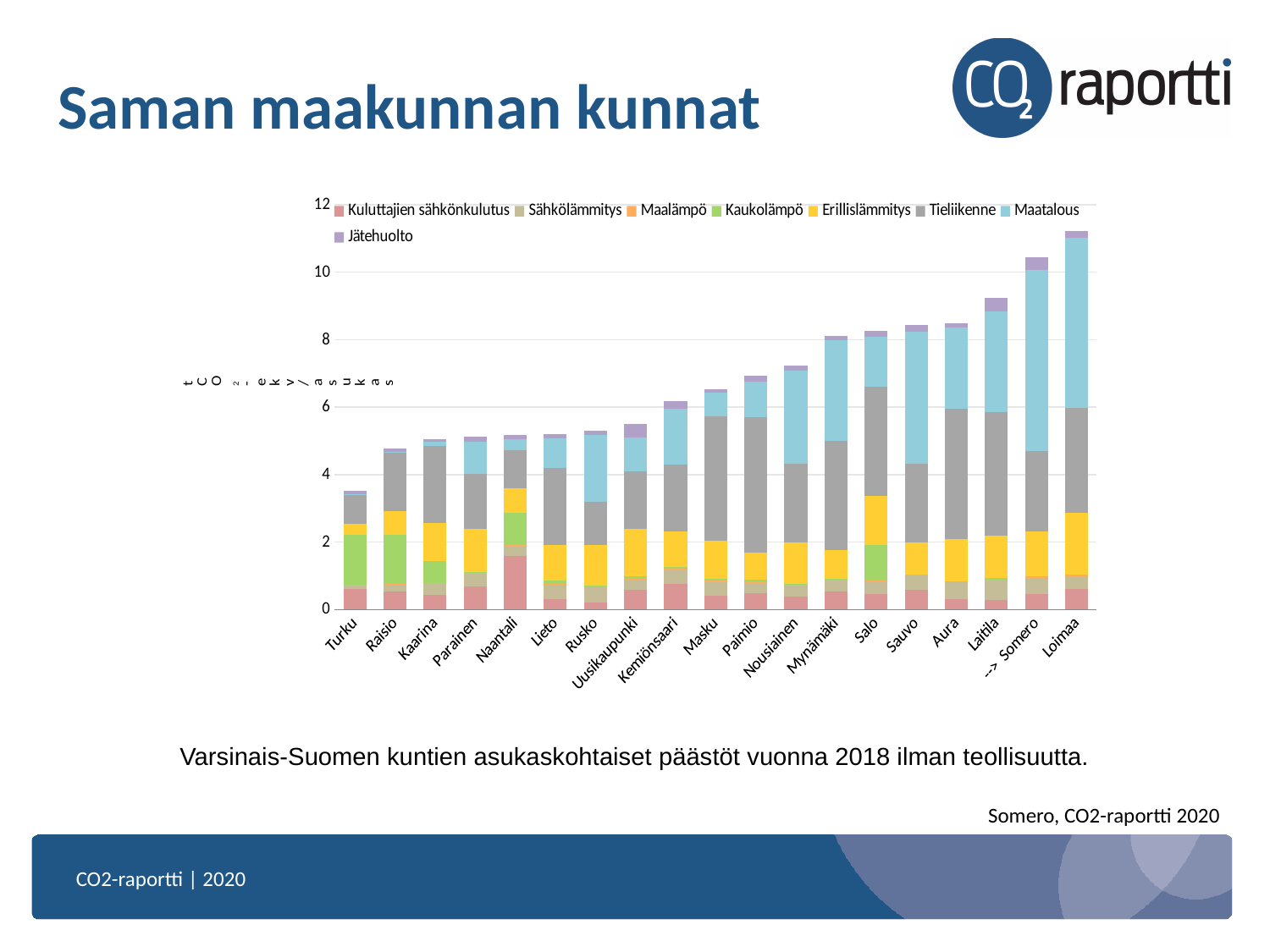
Which has a larger total bar, Raisio or Salo? Salo Is the total value for Salo greater or less than 8? greater Which municipality has the highest total bar in the chart? Loimaa Is the total value for Turku greater or less than 4? less Which series in the legend is shown in light blue? Maatalous Do the total bar heights generally rise or fall from left to right along the x axis? rise Is the total value for Loimaa greater or less than 10? greater Which municipality has the lowest total bar in the chart? Turku How many municipalities (categories) are shown on the x axis of the chart? 19 What kind of chart is shown on the slide? stacked bar chart How many series does the chart legend list? 8